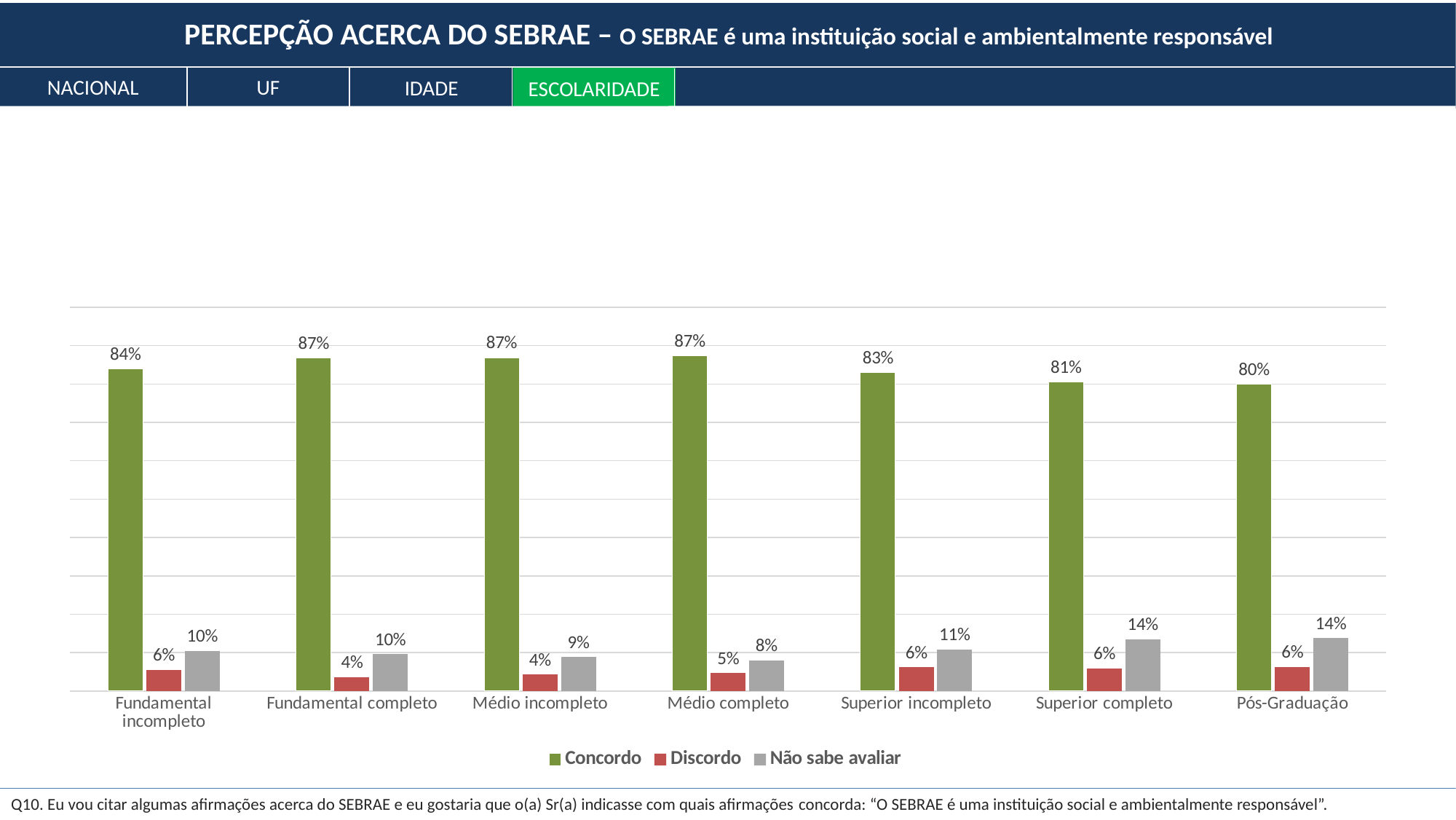
How many education categories are shown on the x axis? 7 What is the Não sabe avaliar value for Superior incompleto? 11% Which category has the lowest Concordo value? Pós-Graduação Do the Concordo values rise or fall from Médio completo to Pós-Graduação? Fall What is the Discordo value for Médio completo? 5% Which category has the lowest Não sabe avaliar value? Médio completo Which tab is highlighted in green at the top of the slide? ESCOLARIDADE How many series does the legend list? 3 Which is larger, the Não sabe avaliar value for Superior completo or for Médio incompleto? Superior completo What kind of chart is shown on the slide? Bar chart What is the Concordo value for Pós-Graduação? 80% What is the difference between the Concordo values for Fundamental completo and Pós-Graduação? 7%